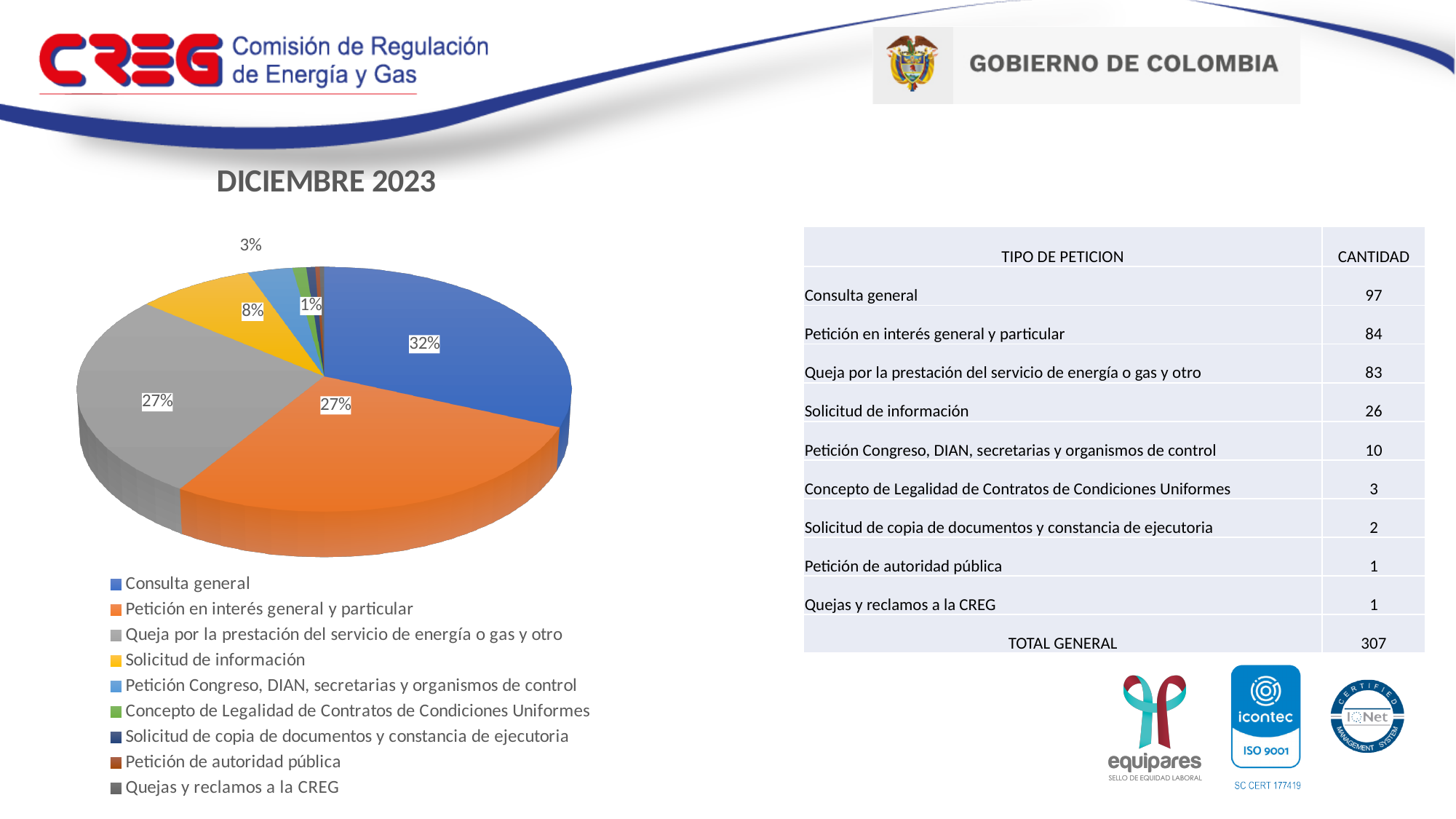
What kind of chart is shown on the slide? pie chart What is the title shown above the pie chart? DICIEMBRE 2023 What percentage is shown for Petición Congreso, DIAN, secretarias y organismos de control in the pie chart? 3% What percentage is shown for Concepto de Legalidad de Contratos de Condiciones Uniformes in the pie chart? 1% Which category has the largest slice of the pie chart? Consulta general What percentage is shown for Solicitud de información in the pie chart? 8% What percentage is shown for Queja por la prestación del servicio de energía o gas y otro in the pie chart? 27% What colour is the slice for Petición en interés general y particular? orange What is the difference in percentage points between Consulta general (32%) and Solicitud de información (8%)? 24 What share of the pie does Consulta general represent? 32% Which is larger in the pie chart: Consulta general or Solicitud de información? Consulta general How many categories does the pie chart legend list? 9